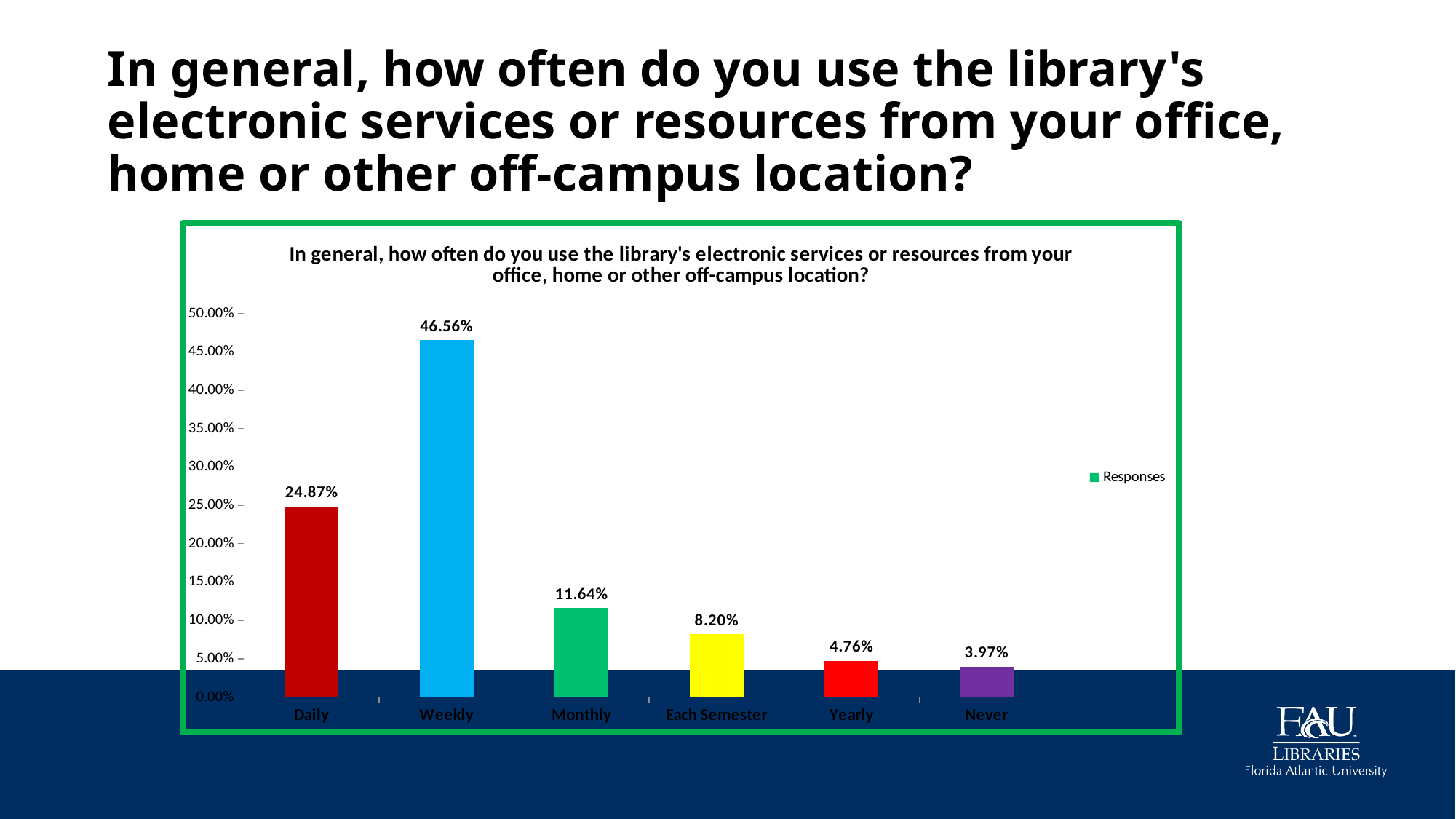
What percentage of responses is shown for Never? 3.97% What series name is listed in the legend? Responses Which category has the highest percentage of responses? Weekly Which category has the lowest percentage of responses? Never What percentage of responses is shown for Each Semester? 8.20% What kind of chart is shown on the slide? Bar chart What is the difference between the Weekly and Daily percentages? 21.69% What percentage of responses is shown for Weekly? 46.56% Is the value for Monthly greater or less than 10.00%? greater What percentage of responses is shown for Daily? 24.87% How many categories are shown on the x axis? 6 Which is larger, the value for Monthly or the value for Yearly? Monthly